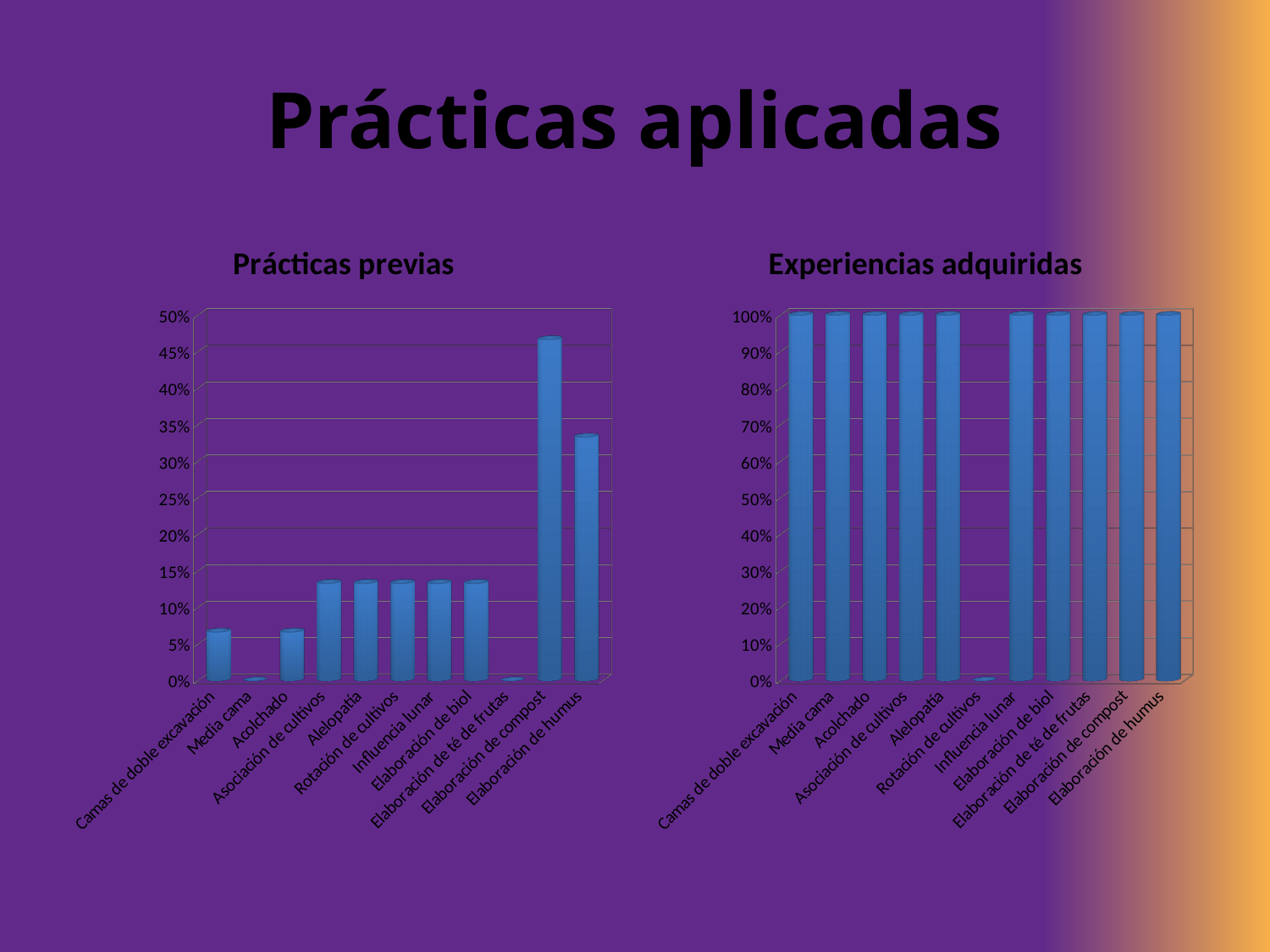
In the "Experiencias adquiridas" chart, which category has the lowest value? Rotación de cultivos What is the title of the chart on the right side of the slide? Experiencias adquiridas In the "Prácticas previas" chart, which category has the highest value? Elaboración de compost In the "Experiencias adquiridas" chart, what is the value for Rotación de cultivos? 0% In the "Prácticas previas" chart, how many categories are shown on the x axis? 11 In the "Prácticas previas" chart, is the value for Elaboración de compost greater or less than 40%? greater In the "Prácticas previas" chart, is the value for Camas de doble excavación greater or less than 10%? less What kind of chart is the "Prácticas previas" chart? bar chart In the "Prácticas previas" chart, which is larger: Elaboración de compost or Elaboración de humus? Elaboración de compost In the "Prácticas previas" chart, is the value for Elaboración de humus greater or less than 30%? greater In the "Experiencias adquiridas" chart, what is the value for Media cama? 100% In the "Prácticas previas" chart, what is the value for Media cama? 0%